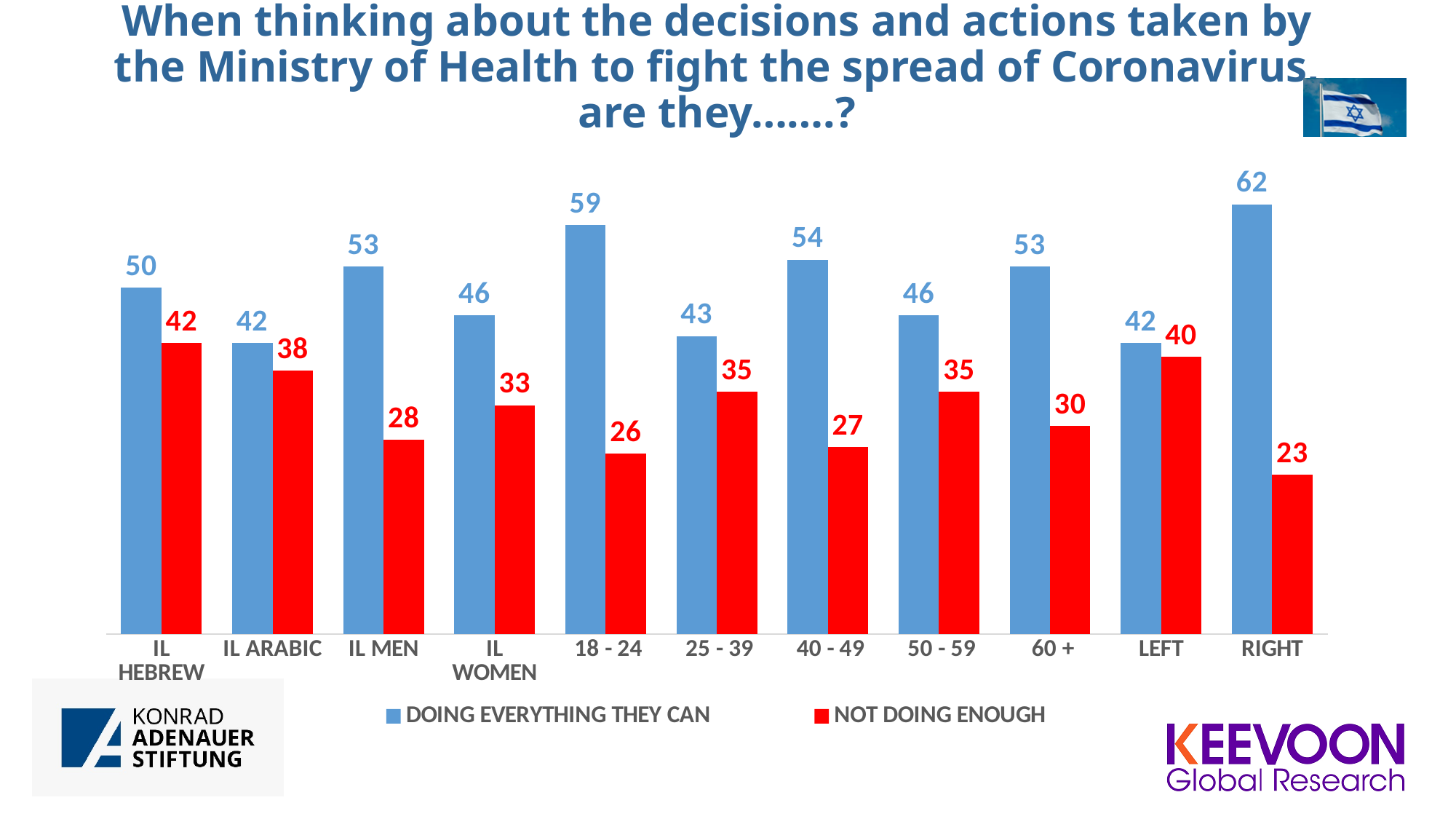
Which category has the highest value for 'DOING EVERYTHING THEY CAN'? RIGHT What kind of chart is shown on the slide? Bar chart What colour represents the 'NOT DOING ENOUGH' series? Red What is the value for 'DOING EVERYTHING THEY CAN' for the 18 - 24 age group? 59 Which category has the highest value for 'NOT DOING ENOUGH'? IL HEBREW How many series does the legend list? 2 Which is larger for the LEFT category: 'DOING EVERYTHING THEY CAN' or 'NOT DOING ENOUGH'? DOING EVERYTHING THEY CAN How many categories are shown on the x axis? 11 Which category has the lowest value for 'NOT DOING ENOUGH'? RIGHT What is the difference between 'DOING EVERYTHING THEY CAN' and 'NOT DOING ENOUGH' for the RIGHT category? 39 What is the value for 'DOING EVERYTHING THEY CAN' for the RIGHT category? 62 What is the value for 'NOT DOING ENOUGH' for IL ARABIC? 38